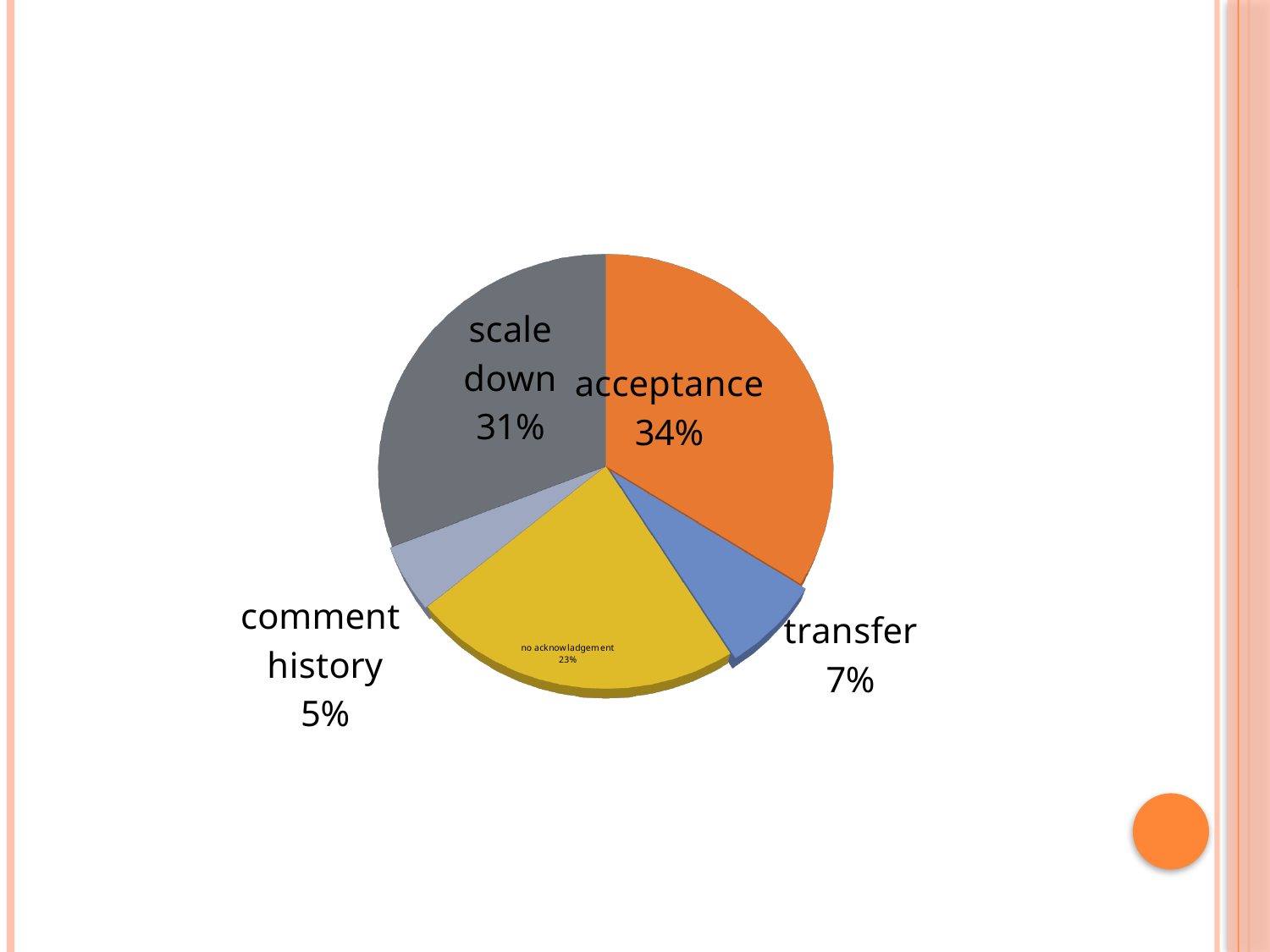
What share of the pie does the transfer slice represent? 7% Which slice of the pie is the largest? acceptance What kind of chart is shown on the slide? pie chart What share of the pie does the scale down slice represent? 31% Which slice of the pie is the smallest? comment history What share of the pie does the comment history slice represent? 5% How many slices does the pie chart have? 5 What is the difference in percentage points between the acceptance and scale down slices? 3 What share of the pie does the acceptance slice represent? 34% What colour is the acceptance slice? orange Which is larger, the transfer slice or the comment history slice? transfer What share of the pie does the no acknowledgement slice represent? 23%